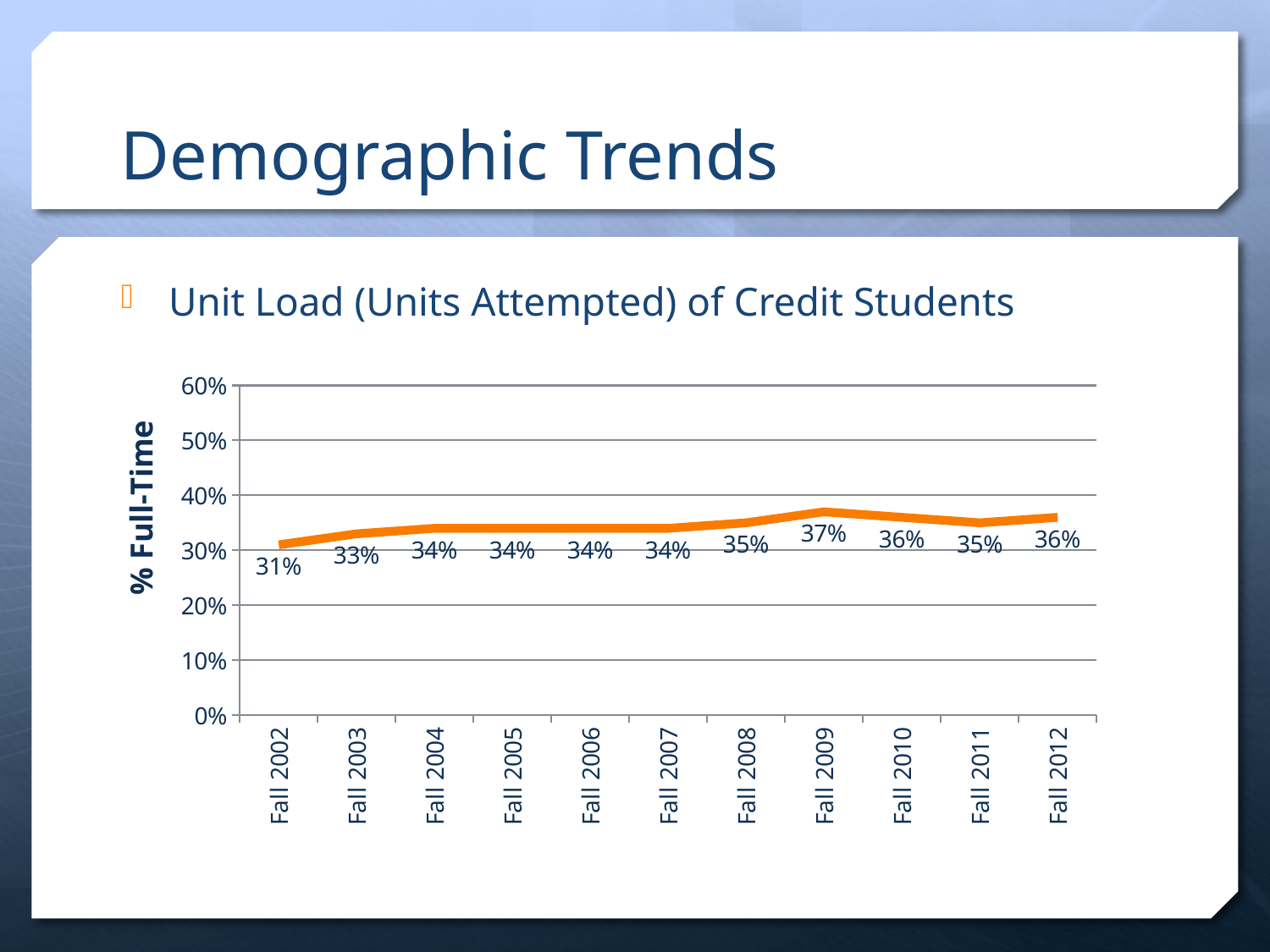
Is the % Full-Time value for Fall 2009 greater or less than 40%? less Which term has the highest % Full-Time value? Fall 2009 What is the difference between the % Full-Time values for Fall 2009 and Fall 2002? 6% Which term has the lowest % Full-Time value? Fall 2002 What is the label on the vertical axis of the chart? % Full-Time What is the % Full-Time value for Fall 2009? 37% How many terms are plotted on the x axis? 11 What kind of chart is shown on the slide? line chart Does the % Full-Time value generally rise or fall from Fall 2002 to Fall 2012? rise What is the % Full-Time value for Fall 2012? 36% What is the % Full-Time value for Fall 2002? 31% Which is larger, the % Full-Time value for Fall 2010 or for Fall 2011? Fall 2010